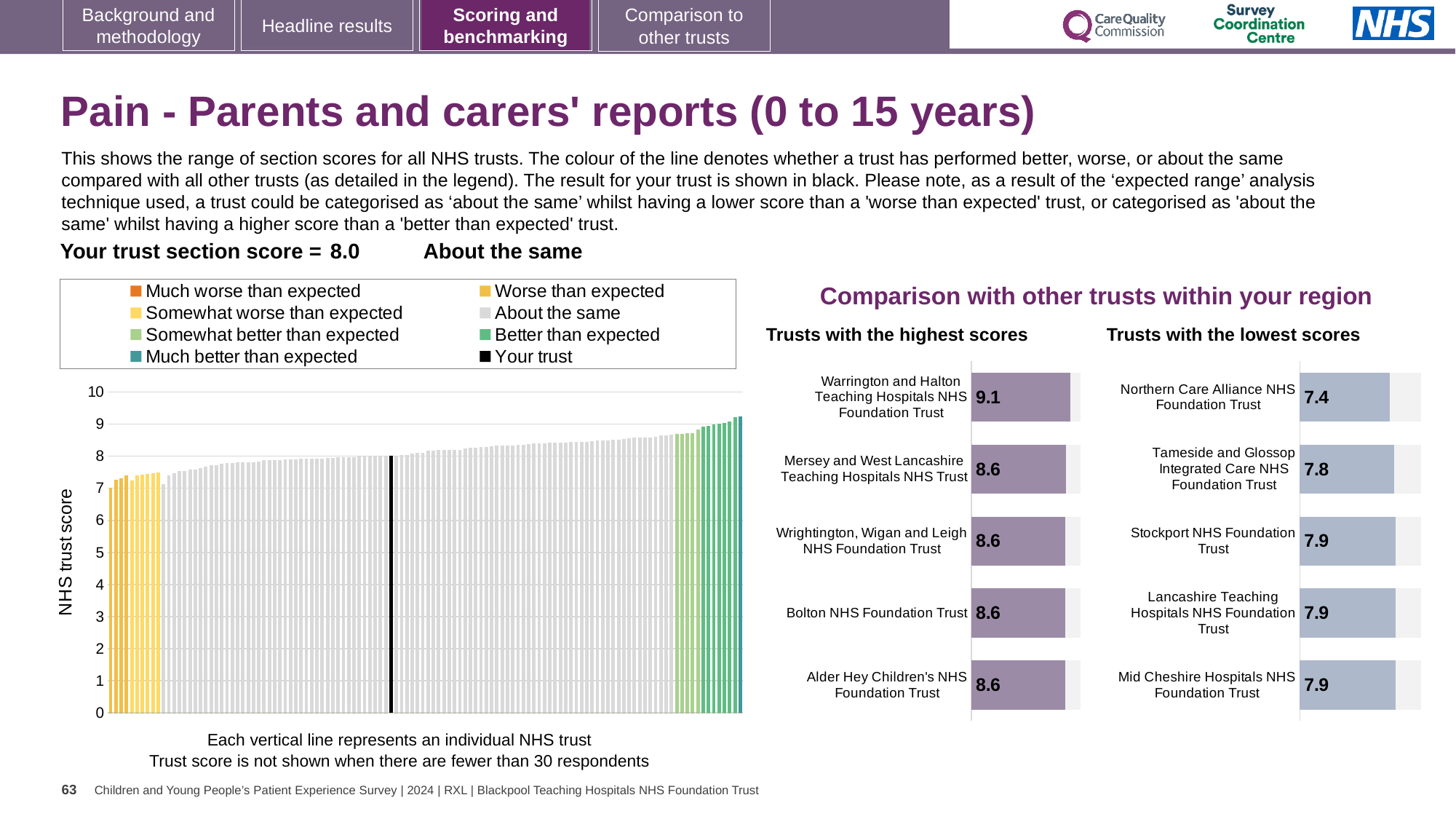
In the 'Trusts with the highest scores' chart, what is the difference between the scores of Warrington and Halton and Bolton NHS Foundation Trust? 0.5 In the 'NHS trust score' chart on the left, do the bar values rise or fall from left to right? Rise In the 'Trusts with the highest scores' chart, which trust has the highest score? Warrington and Halton Teaching Hospitals NHS Foundation Trust How many trusts are shown in the 'Trusts with the lowest scores' chart? 5 In the 'Trusts with the lowest scores' chart, what is the score for Tameside and Glossop Integrated Care NHS Foundation Trust? 7.8 What type of chart is the 'NHS trust score' chart on the left? Bar chart In the 'Trusts with the highest scores' chart, what is the score for Warrington and Halton Teaching Hospitals NHS Foundation Trust? 9.1 What is the difference between Warrington and Halton's score in the 'Trusts with the highest scores' chart and Northern Care Alliance's score in the 'Trusts with the lowest scores' chart? 1.7 In the 'Trusts with the lowest scores' chart, which trust has the lowest score? Northern Care Alliance NHS Foundation Trust Which is larger: Stockport NHS Foundation Trust's score in the 'Trusts with the lowest scores' chart or Mersey and West Lancashire's score in the 'Trusts with the highest scores' chart? Mersey and West Lancashire Teaching Hospitals NHS Trust In the 'Trusts with the lowest scores' chart, what is the score for Northern Care Alliance NHS Foundation Trust? 7.4 How many entries does the legend of the 'NHS trust score' chart list? 8